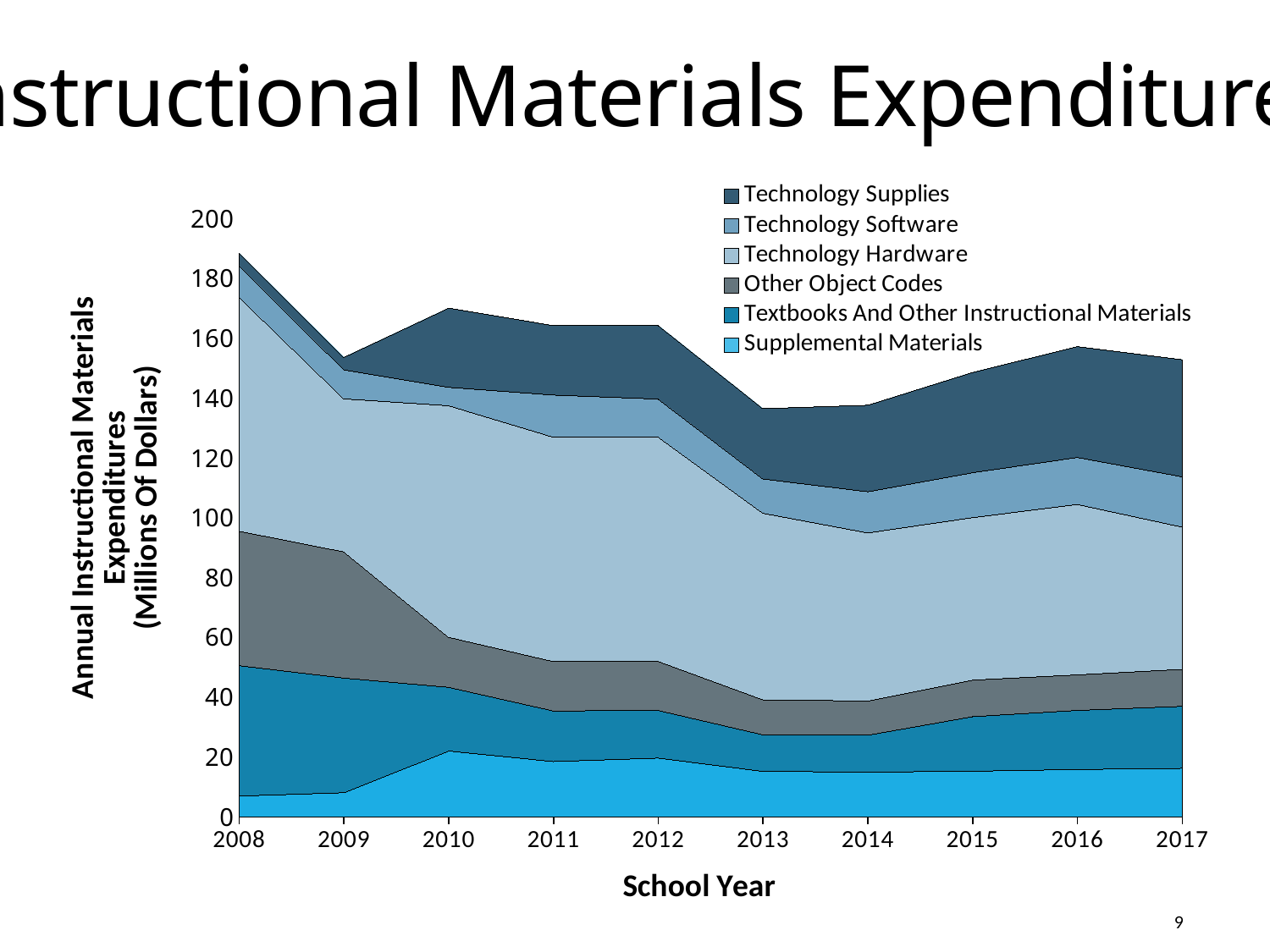
Which school year has the highest total annual instructional materials expenditure? 2008 Which series is listed first in the legend? Technology Supplies What kind of chart is shown on the slide? Stacked area chart Is the total expenditure for 2008 greater or less than 180? greater How many series does the legend list? 6 Does the total expenditure rise or fall from 2008 to 2013? fall How many school years are plotted along the x axis? 10 Is the total expenditure larger in 2008 or in 2017? 2008 What is the title of the x axis? School Year Is the total expenditure for 2013 greater or less than 140? less Is the total expenditure for 2010 greater or less than 160? greater